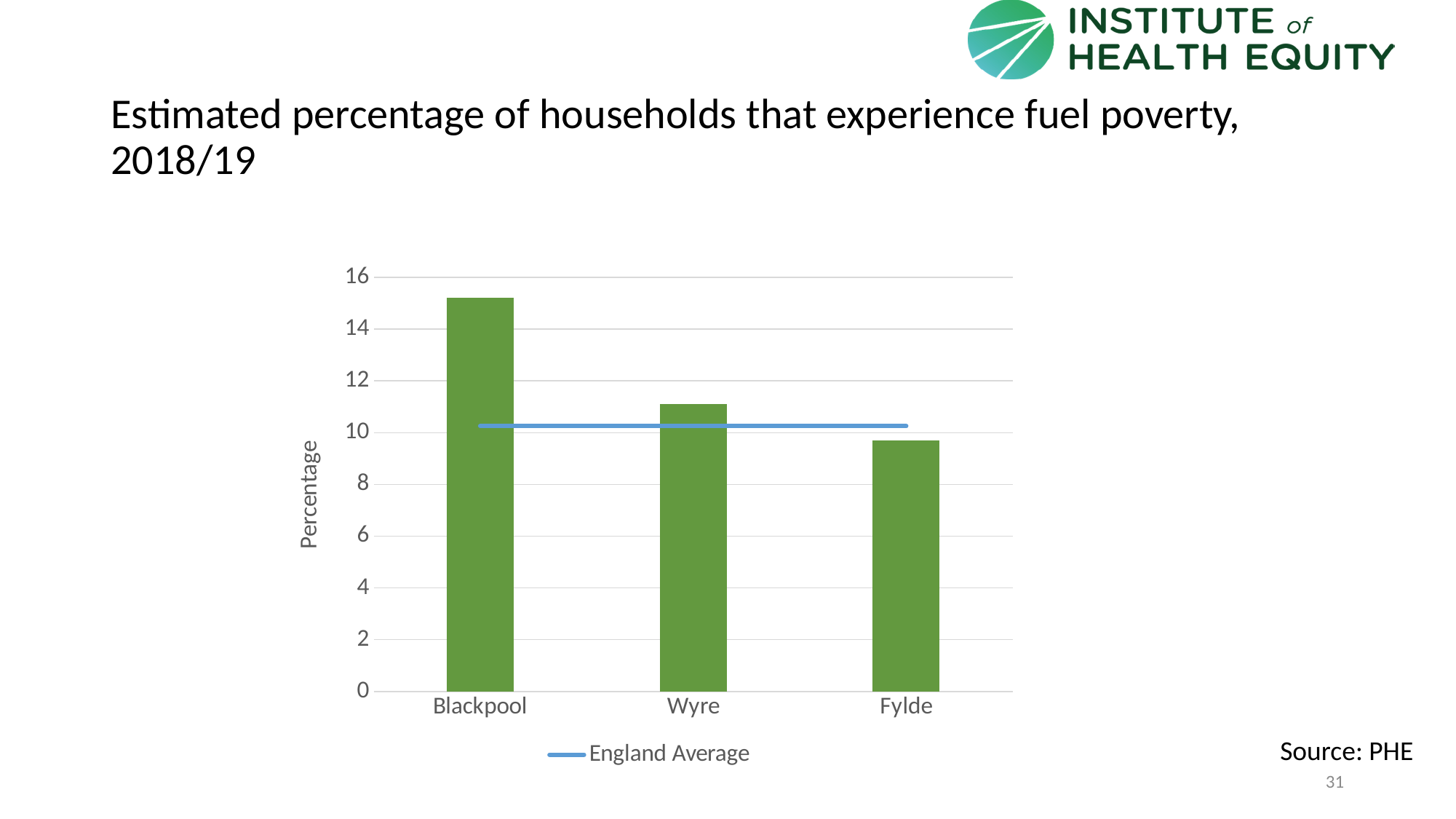
Is the value for Wyre greater or less than 12? less Is the value for Fylde greater or less than 12? less Which area has the lowest estimated percentage of households in fuel poverty? Fylde Which area has the highest estimated percentage of households in fuel poverty? Blackpool Is the value for Fylde greater or less than 8? greater How many areas are shown on the x axis of the chart? 3 What does the horizontal blue line on the chart represent, according to the legend? England Average Which is larger, the value for Blackpool or the value for Wyre? Blackpool Do the bar values rise or fall from left to right across the x axis? fall What kind of chart is shown on the slide? bar chart